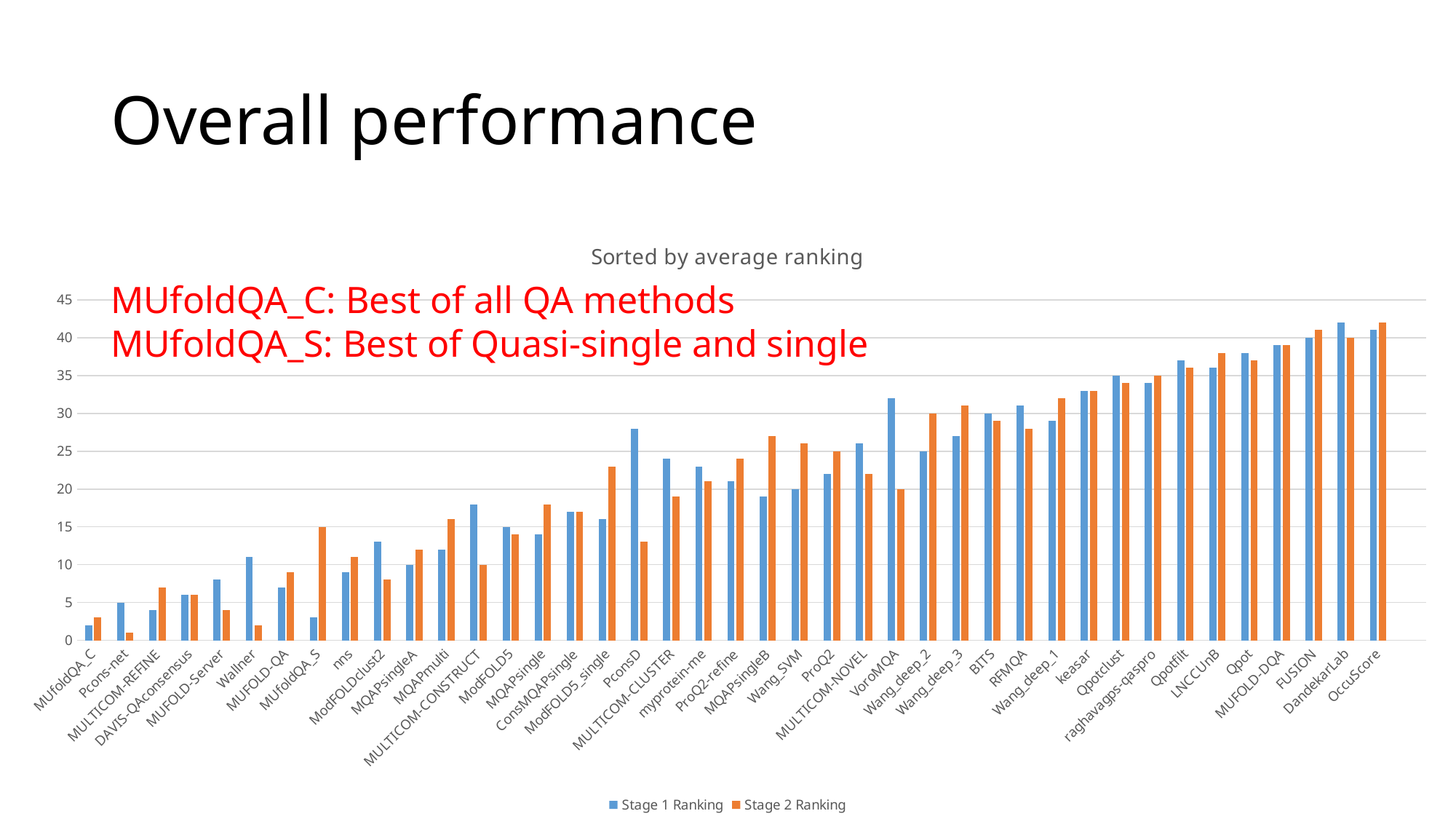
For MUfoldQA_S, which is larger: the Stage 1 Ranking or the Stage 2 Ranking? Stage 2 Ranking What kind of chart is shown on the slide? bar chart For PconsD, which is larger: the Stage 1 Ranking or the Stage 2 Ranking? Stage 1 Ranking Is the Stage 1 Ranking for PconsD greater or less than 25? greater How many series does the legend list? 2 What are the two series named in the legend? Stage 1 Ranking and Stage 2 Ranking Which method has the lowest Stage 2 Ranking? Pcons-net Is the Stage 1 Ranking for VoroMQA greater or less than 30? greater How many QA methods (categories) are shown on the x axis? 41 Is the Stage 1 Ranking for MUfoldQA_S greater or less than 5? less Do the ranking values generally rise or fall moving left to right along the x axis? rise